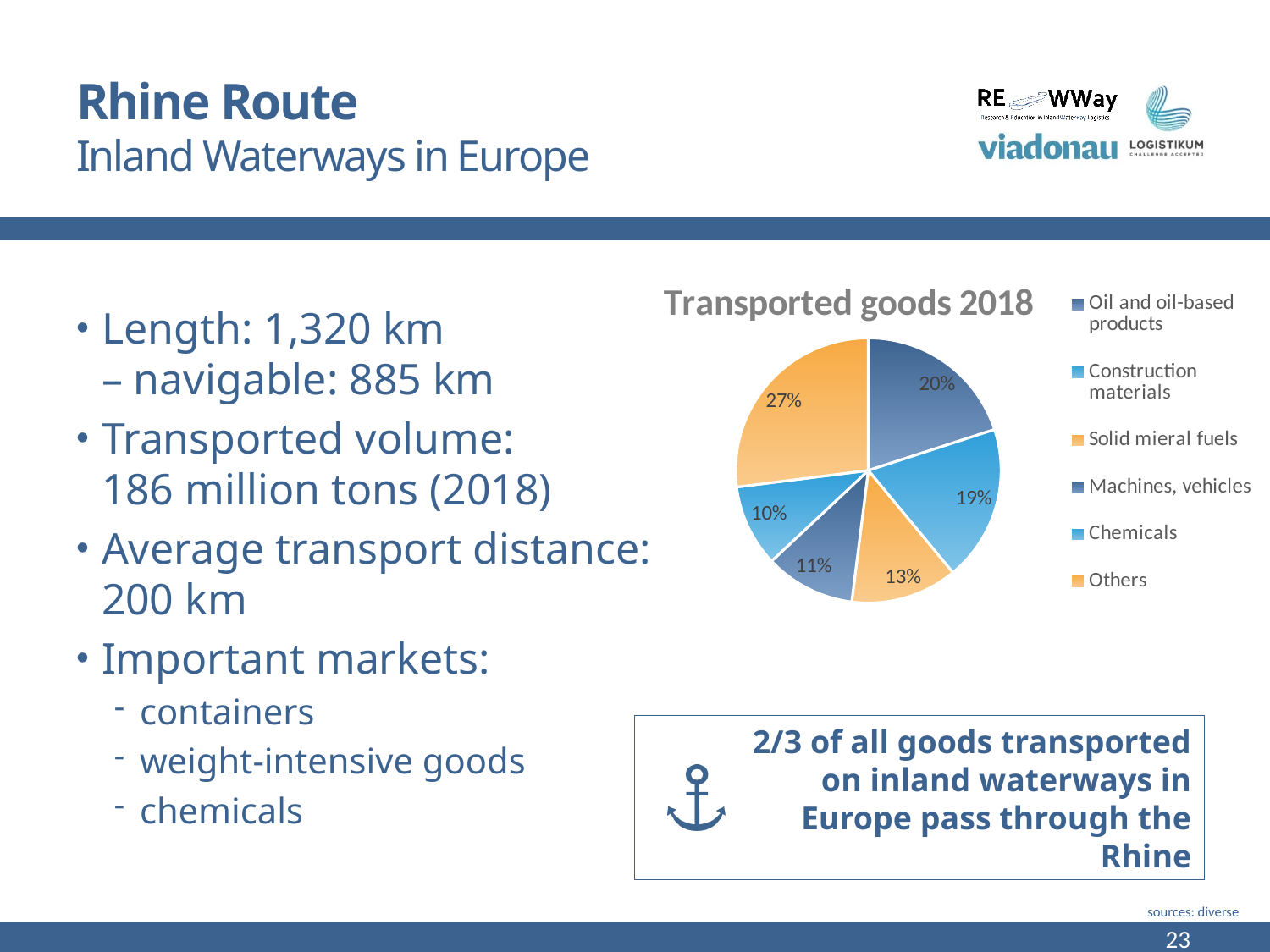
Which category has the smallest share of the pie chart? Chemicals What type of chart is shown on the slide? pie chart Which category has the largest share of the pie chart? Others What share of transported goods in 2018 is Machines, vehicles? 11% What share of transported goods in 2018 is Chemicals? 10% Which has a larger share, Construction materials or Solid mineral fuels? Construction materials What share of transported goods in 2018 is Oil and oil-based products? 20% How many categories does the legend of the pie chart list? 6 What is the difference in percentage points between the Others slice and the Oil and oil-based products slice? 7 What is the title of the chart? Transported goods 2018